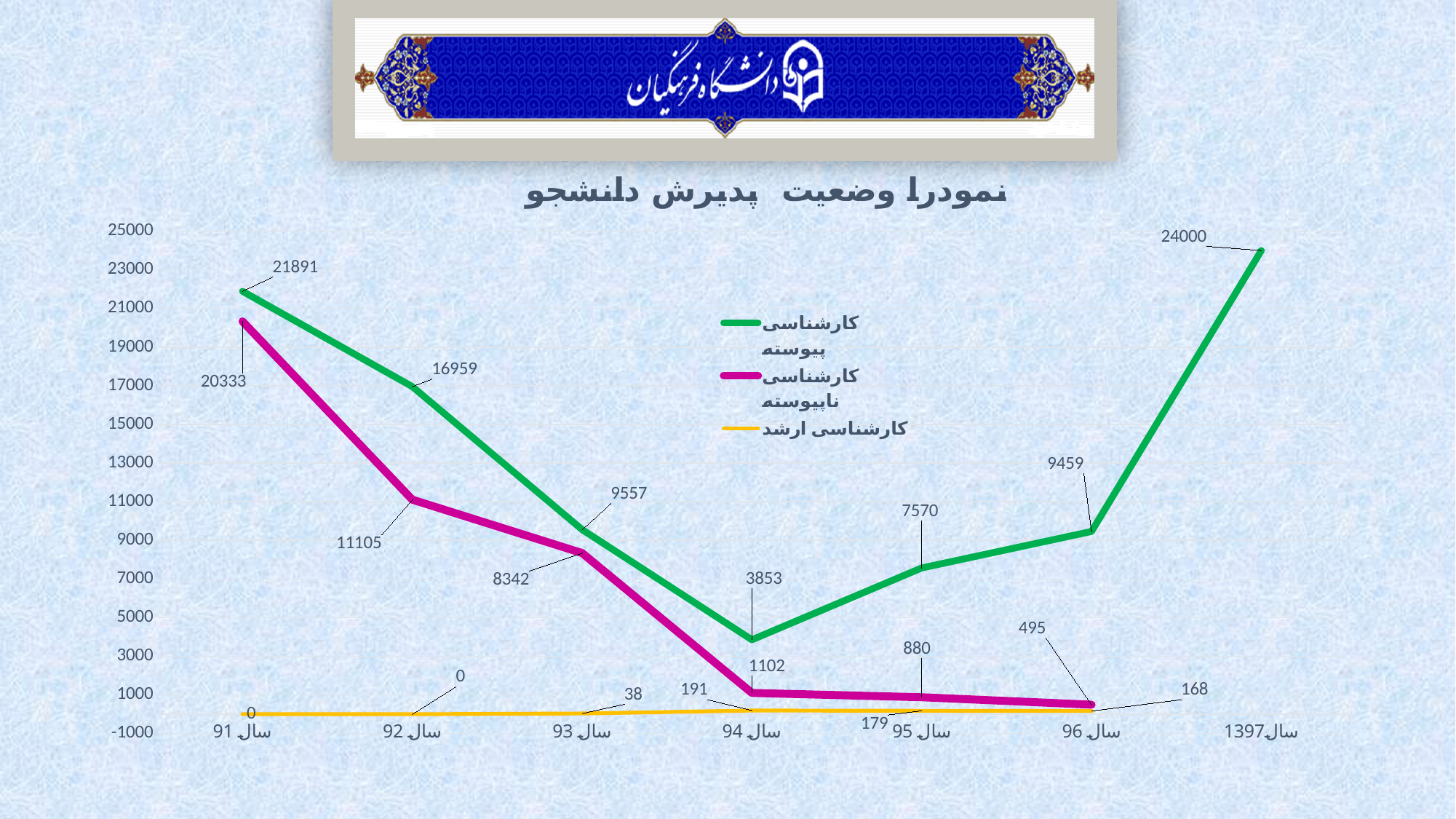
What is the value of کارشناسی پیوسته in سال 91? 21891 In which year is کارشناسی پیوسته at its lowest? سال 94 What is the value of کارشناسی پیوسته in سال1397? 24000 What type of chart is shown on the slide? line chart In which year is کارشناسی ناپیوسته at its highest? سال 91 What is the value of کارشناسی ارشد in سال 94? 191 How many series does the legend list? 3 Which is larger in سال 95: کارشناسی ناپیوسته or کارشناسی ارشد? کارشناسی ناپیوسته What is the difference between کارشناسی پیوسته and کارشناسی ناپیوسته in سال 93? 1215 Does کارشناسی ناپیوسته rise or fall from سال 91 to سال 96? fall What is the title of the chart? نمودرا وضعیت پدیرش دانشجو What is the value of کارشناسی ناپیوسته in سال 92? 11105